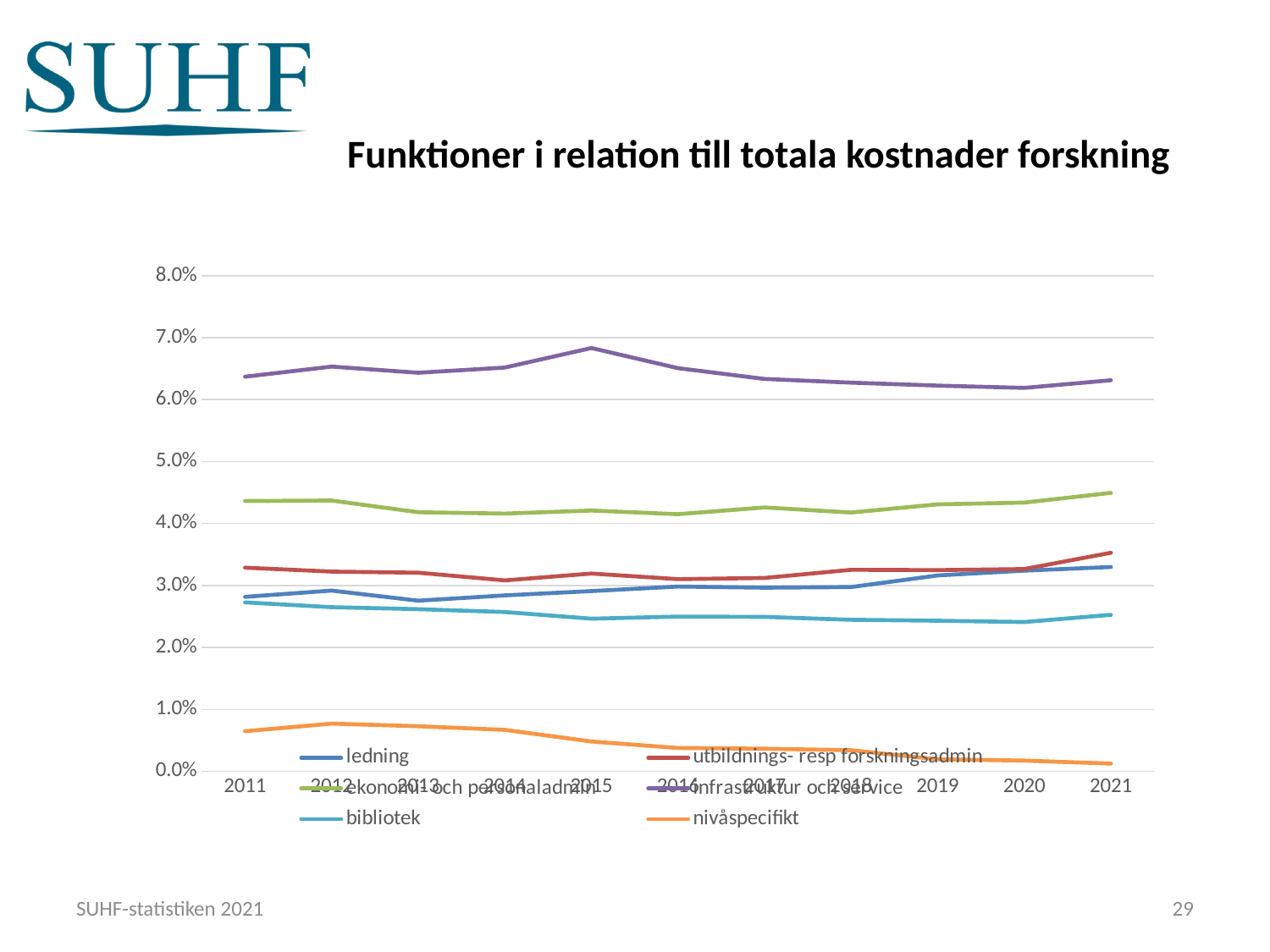
How many series does the legend list? 6 Is the value for ekonomi- och personaladmin in 2021 greater or less than 4.0%? greater Which series has the highest values across the whole period? infrastruktur och service What is the title of the chart? Funktioner i relation till totala kostnader forskning Is the value for bibliotek in 2021 greater or less than 3.0%? less How many years are plotted along the x axis? 11 Which series has the lowest values across the whole period? nivåspecifikt Is the value for nivåspecifikt in 2021 greater or less than 1.0%? less In 2021, which is larger: ekonomi- och personaladmin or utbildnings- resp forskningsadmin? ekonomi- och personaladmin Does the nivåspecifikt series rise or fall from 2011 to 2021? fall What kind of chart is shown on the slide? line chart